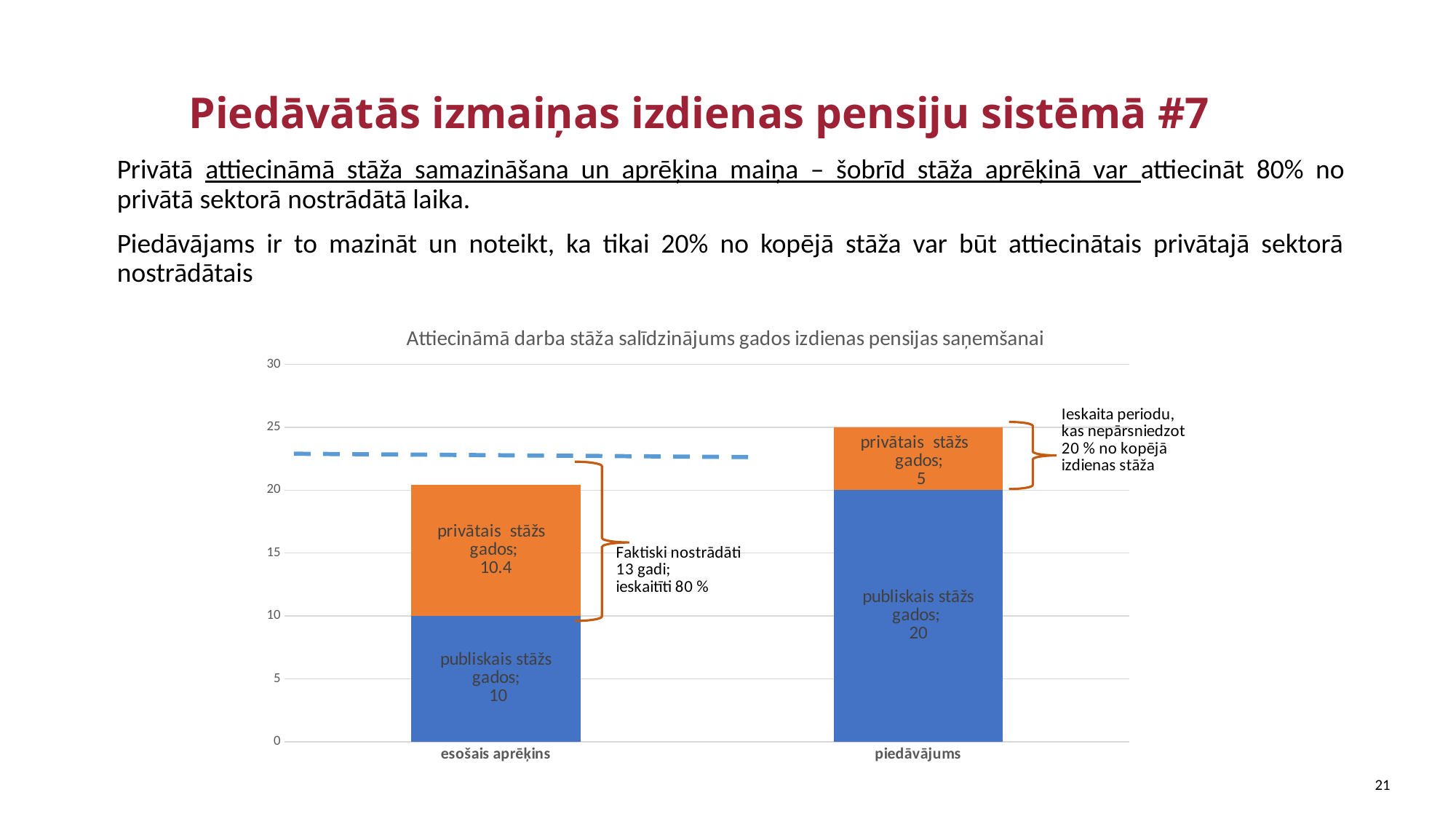
What is the total of the stacked bar for 'esošais aprēķins'? 20.4 What is the difference in 'publiskais stāžs gados' between 'piedāvājums' and 'esošais aprēķins'? 10 How many categories are shown on the x axis? 2 What is the title of the chart? Attiecināmā darba stāža salīdzinājums gados izdienas pensijas saņemšanai What is the value of 'privātais stāžs gados' for 'piedāvājums'? 5 Which category has the higher value for 'privātais stāžs gados'? esošais aprēķins Is the total for 'piedāvājums' greater or less than 30? less What is the total of the stacked bar for 'piedāvājums'? 25 What is the value of 'publiskais stāžs gados' for 'esošais aprēķins'? 10 What kind of chart is shown on the slide? Stacked bar chart What is the value of 'publiskais stāžs gados' for 'piedāvājums'? 20 What is the value of 'privātais stāžs gados' for 'esošais aprēķins'? 10.4